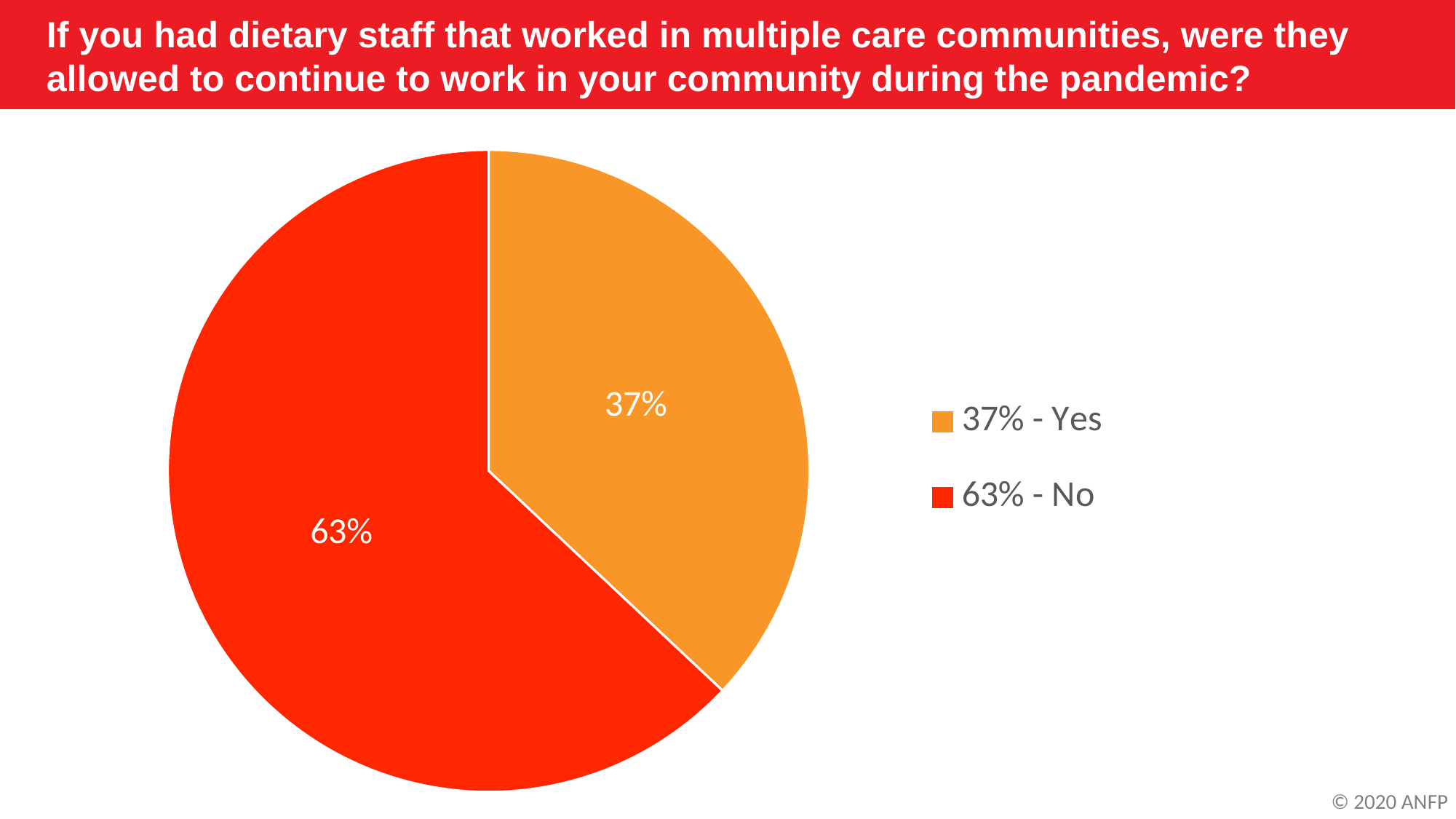
Which is larger, the share for Yes or the share for No? No Which response has the smallest share of the pie? Yes How many slices does the pie chart have? 2 What kind of chart is shown on the slide? pie chart What colour is the slice representing Yes? orange What share of the pie does the No slice represent? 63% What is the difference in percentage points between the No and Yes responses? 26 How many entries does the legend list? 2 What percentage of respondents answered No? 63% What percentage of respondents answered Yes? 37% Which response has the largest share of the pie? No What is the legend entry for the red slice? 63% - No